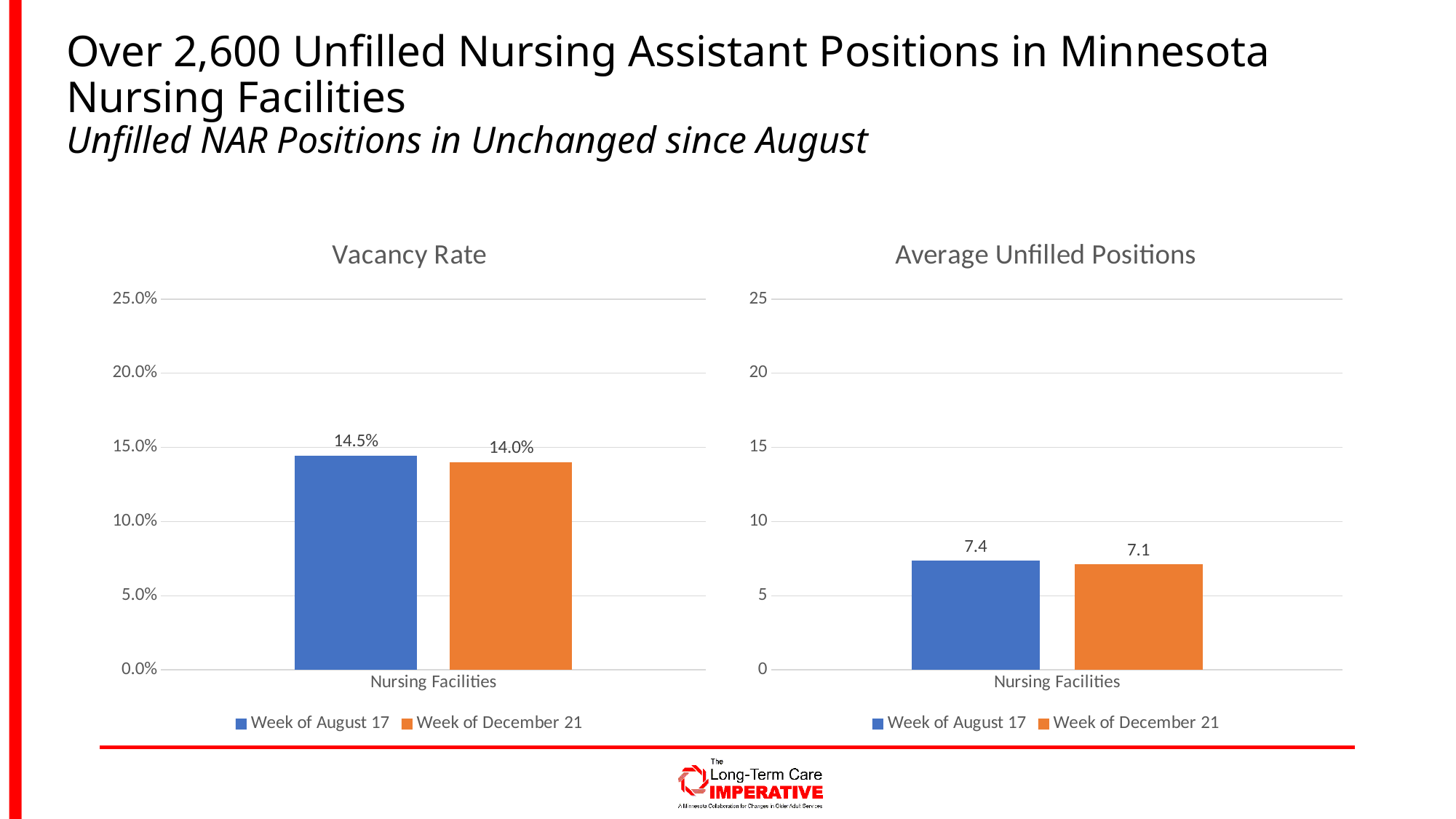
What kind of chart is the Average Unfilled Positions chart? bar chart In the Vacancy Rate chart, which series has the higher value? Week of August 17 In the Average Unfilled Positions chart, is the value for Week of August 17 greater or less than 10? less In the Vacancy Rate chart, what is the value for Week of August 17? 14.5% In the Vacancy Rate chart, what is the value for Week of December 21? 14.0% What is the category label on the x axis of the Vacancy Rate chart? Nursing Facilities In the Average Unfilled Positions chart, which series has the lower value? Week of December 21 In the Average Unfilled Positions chart, what is the value for Week of August 17? 7.4 In the Vacancy Rate chart, what is the difference between the Week of August 17 and Week of December 21 values? 0.5% How many series does the legend of the Vacancy Rate chart list? 2 In the Average Unfilled Positions chart, what is the difference between the Week of August 17 and Week of December 21 values? 0.3 In the Average Unfilled Positions chart, what is the value for Week of December 21? 7.1